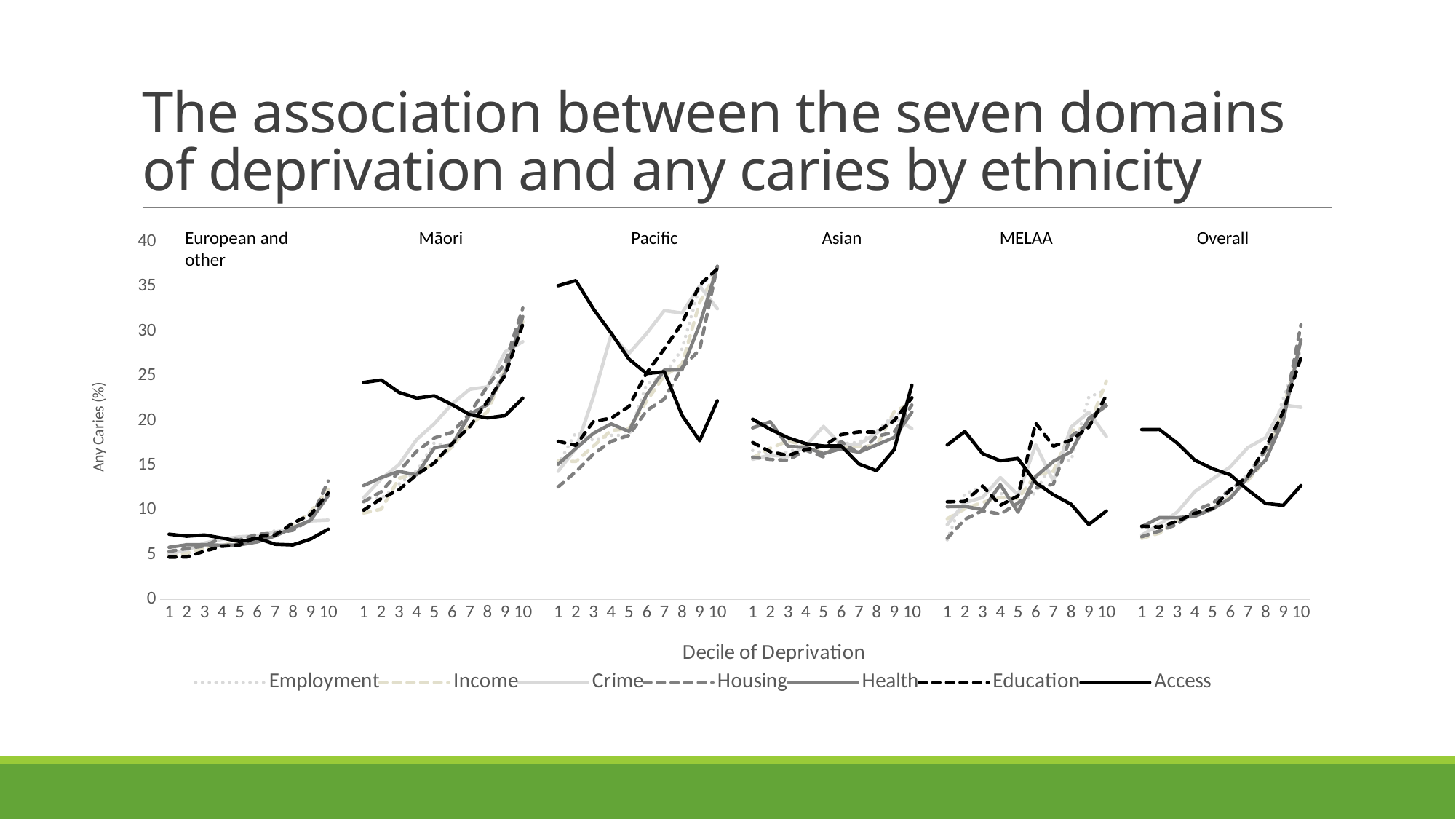
In the Overall panel, does the Access line rise or fall from decile 1 to decile 9? fall What kind of chart is shown on the slide? line chart In the Pacific panel, is the Access value at decile 2 greater or less than 30? greater In the Overall panel, does the Education line rise or fall from decile 1 to decile 10? rise In the European and other panel, is the Access value at decile 10 greater or less than 10? less How many ethnic group panels are shown in the chart? 6 Which ethnic group panel reaches the highest Any Caries (%) value in the chart? Pacific What is the title of the y axis? Any Caries (%) How many deciles are plotted along the x axis within each ethnic group panel? 10 In the Māori panel, is the Access value at decile 1 greater or less than 20? greater What is the title of the x axis? Decile of Deprivation How many series does the legend list? 7